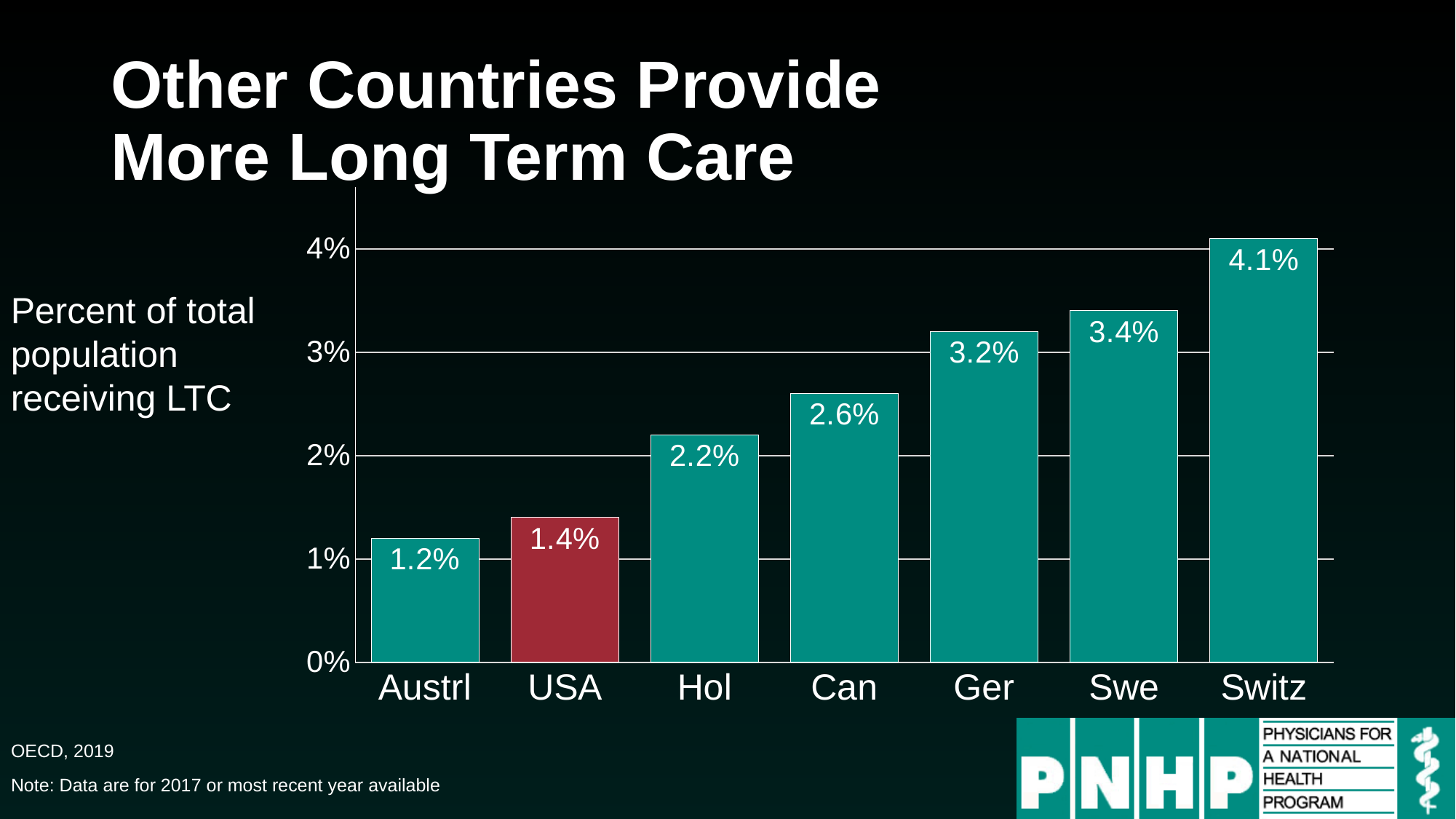
Which country has the lowest value? Austrl Is the value for Ger greater or less than 3%? greater What is the difference between the values for Ger and Hol? 1.0% Which is larger, the value for Swe or the value for Can? Swe What is the value for Can? 2.6% How many countries are shown on the chart? 7 What is the value for Switz? 4.1% Which country's bar is coloured red instead of teal? USA What kind of chart is shown on the slide? bar chart Which country has the highest value? Switz What is the difference between the values for Switz and USA? 2.7% What is the value for USA? 1.4%